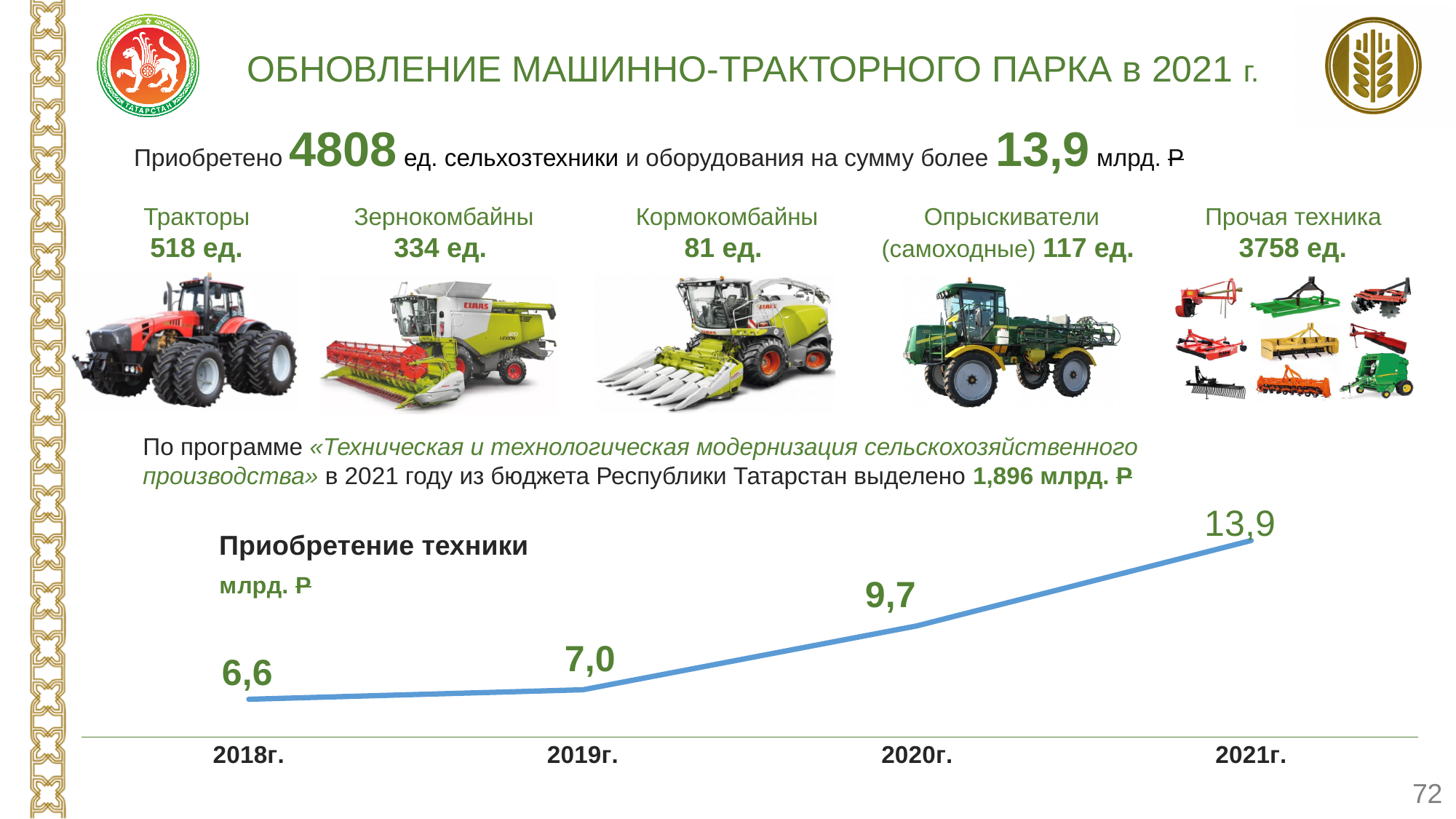
How many years are plotted in the 'Приобретение техники' chart? 4 What is the difference between the 2019г. and 2018г. values in the 'Приобретение техники' chart? 0,4 Which year has the lowest value in the 'Приобретение техники' chart? 2018г. Do the values in the 'Приобретение техники' chart rise or fall from 2018г. to 2021г.? rise What is the value for 2019г. in the 'Приобретение техники' chart? 7,0 Which is larger in the 'Приобретение техники' chart: the value for 2020г. or 2019г.? 2020г. What is the value for 2020г. in the 'Приобретение техники' chart? 9,7 What is the difference between the 2021г. and 2020г. values in the 'Приобретение техники' chart? 4,2 What is the value for 2021г. in the 'Приобретение техники' chart? 13,9 Which year has the highest value in the 'Приобретение техники' chart? 2021г. What is the value for 2018г. in the 'Приобретение техники' chart? 6,6 What type of chart is used to show 'Приобретение техники'? line chart